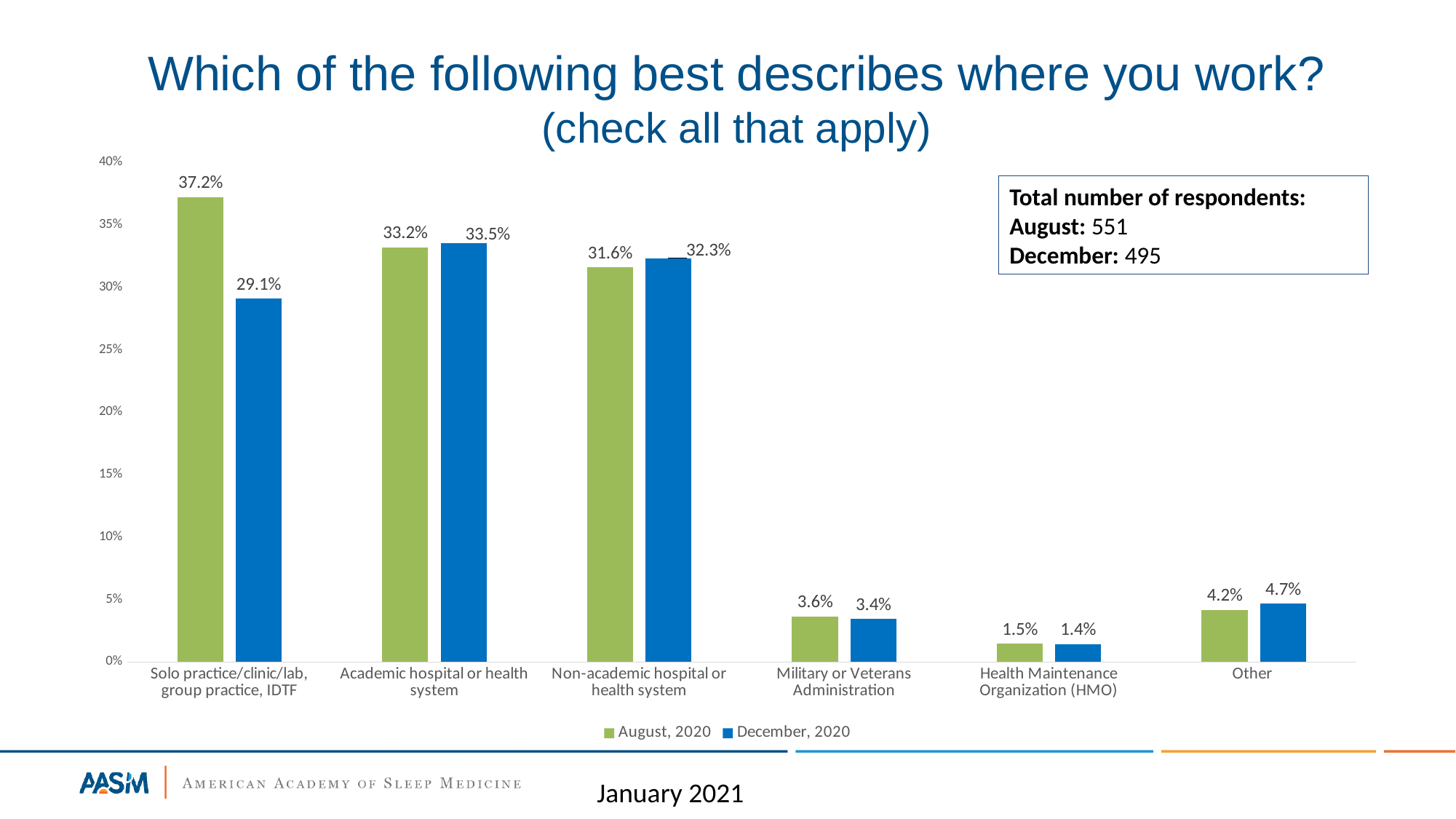
How many categories are shown on the x axis? 6 What is the August, 2020 value for Solo practice/clinic/lab, group practice, IDTF? 37.2% Which category has the highest August, 2020 value? Solo practice/clinic/lab, group practice, IDTF Is the December, 2020 value for Solo practice/clinic/lab, group practice, IDTF greater or less than 30%? less How many series does the legend list? 2 Which is larger for Non-academic hospital or health system: the August, 2020 value or the December, 2020 value? December, 2020 What is the December, 2020 value for Academic hospital or health system? 33.5% Which category has the lowest December, 2020 value? Health Maintenance Organization (HMO) What is the difference between the August, 2020 and December, 2020 values for Solo practice/clinic/lab, group practice, IDTF? 8.1% What is the December, 2020 value for Other? 4.7% What colour are the August, 2020 bars? green What kind of chart is shown on the slide? bar chart